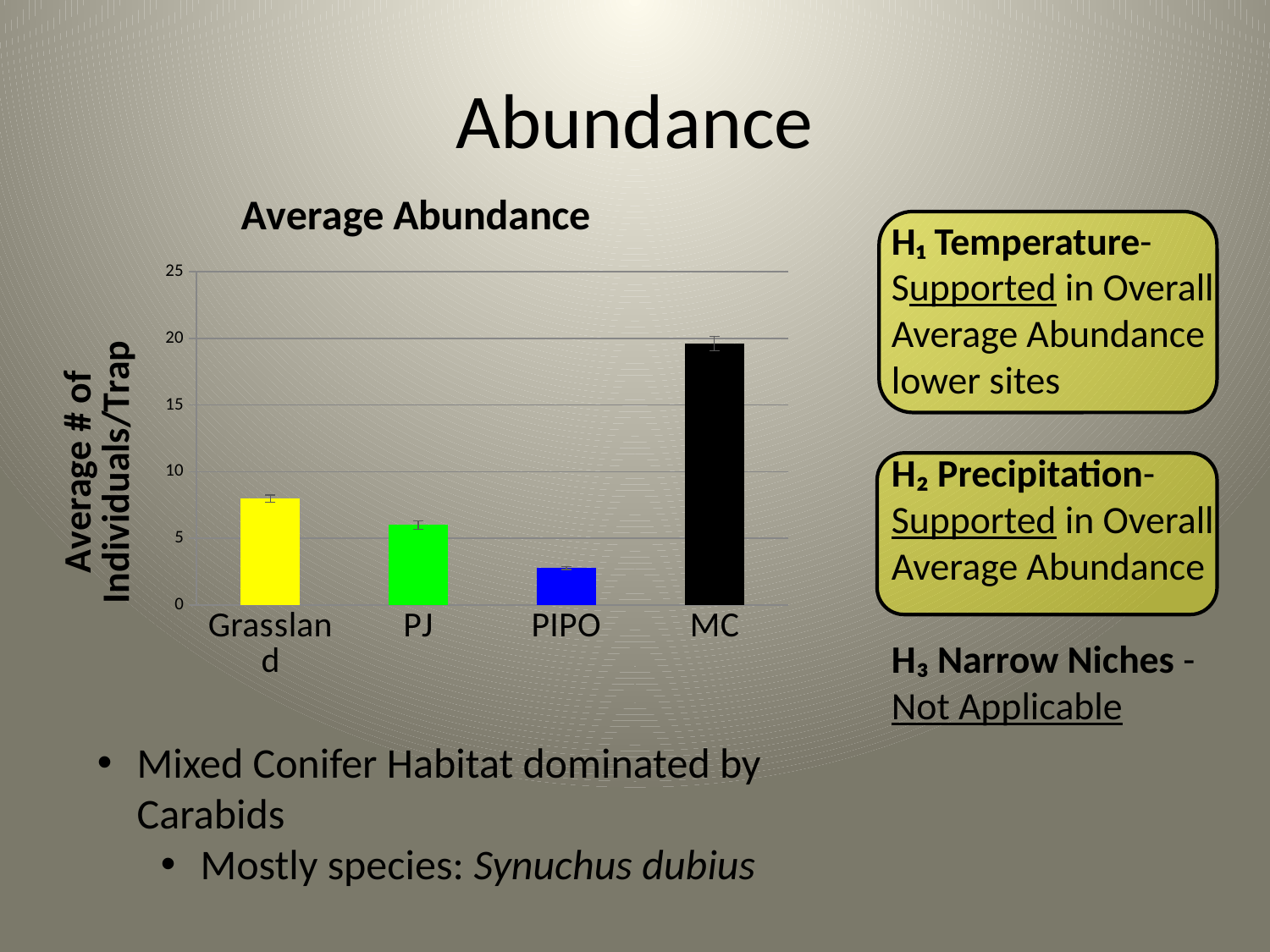
Is the value for Grassland greater or less than 5? greater How many habitat categories are plotted on the x axis of the chart? 4 Which has a higher average abundance, PIPO or MC? MC Is the value for Grassland greater or less than 10? less What type of chart is shown on the slide? bar chart Which has a higher average abundance, Grassland or PJ? Grassland Is the value for PIPO greater or less than 5? less Which category has the lowest average abundance? PIPO What is the label on the y axis of the chart? Average # of Individuals/Trap What is the title of the chart? Average Abundance Which category has the highest average abundance? MC